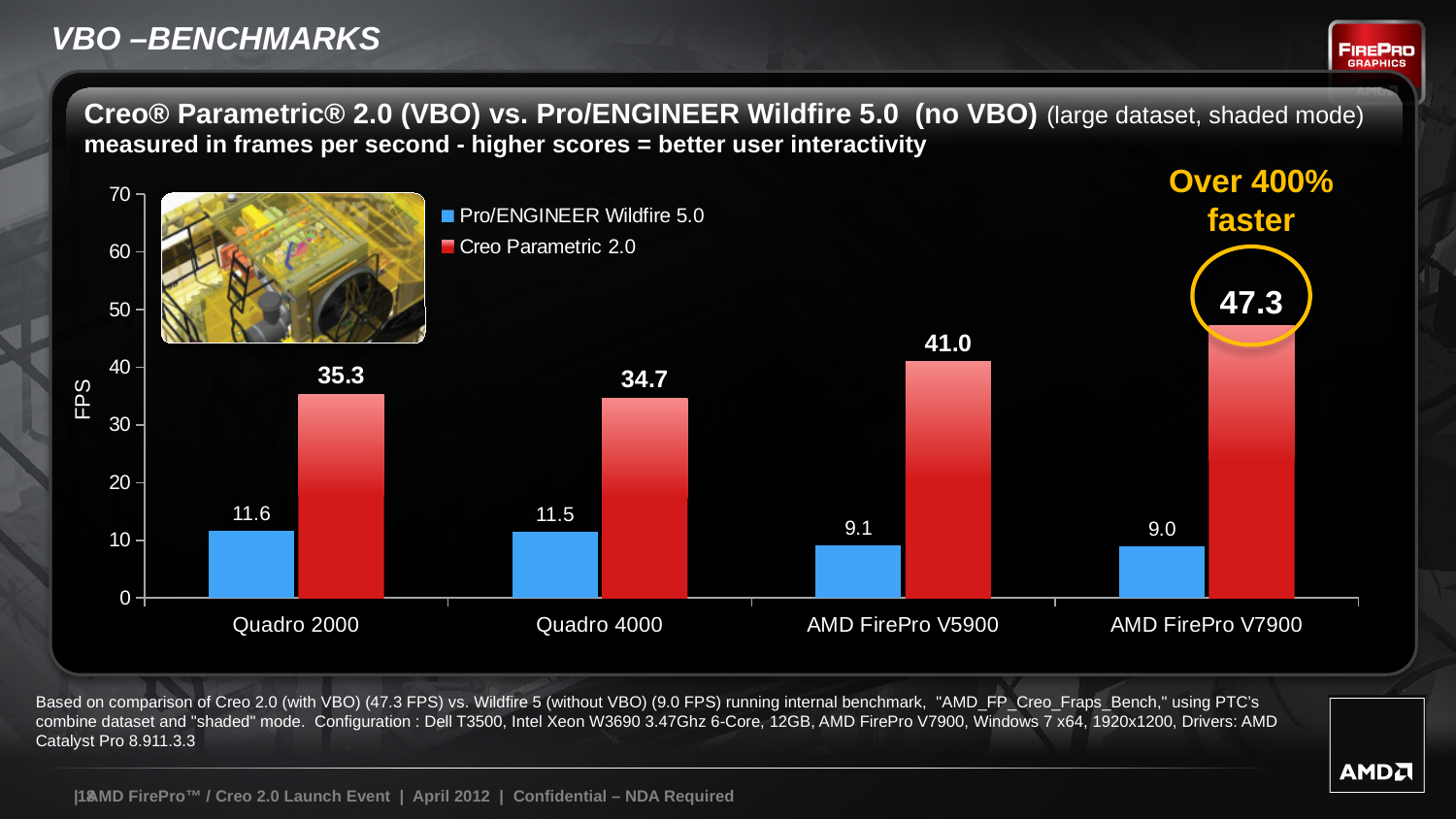
What is the Creo Parametric 2.0 value for Quadro 4000? 34.7 How many series does the legend list? 2 Which category has the highest Creo Parametric 2.0 value? AMD FirePro V7900 What is the difference between the Creo Parametric 2.0 and Pro/ENGINEER Wildfire 5.0 values for AMD FirePro V7900? 38.3 What is the Creo Parametric 2.0 value for AMD FirePro V7900? 47.3 Which is larger: the Creo Parametric 2.0 value for Quadro 2000 or for AMD FirePro V5900? AMD FirePro V5900 What is the label of the y axis? FPS How many categories are shown on the x axis? 4 What is the Pro/ENGINEER Wildfire 5.0 value for Quadro 2000? 11.6 What kind of chart is shown on the slide? bar chart What is the Pro/ENGINEER Wildfire 5.0 value for AMD FirePro V5900? 9.1 Which category has the lowest Pro/ENGINEER Wildfire 5.0 value? AMD FirePro V7900